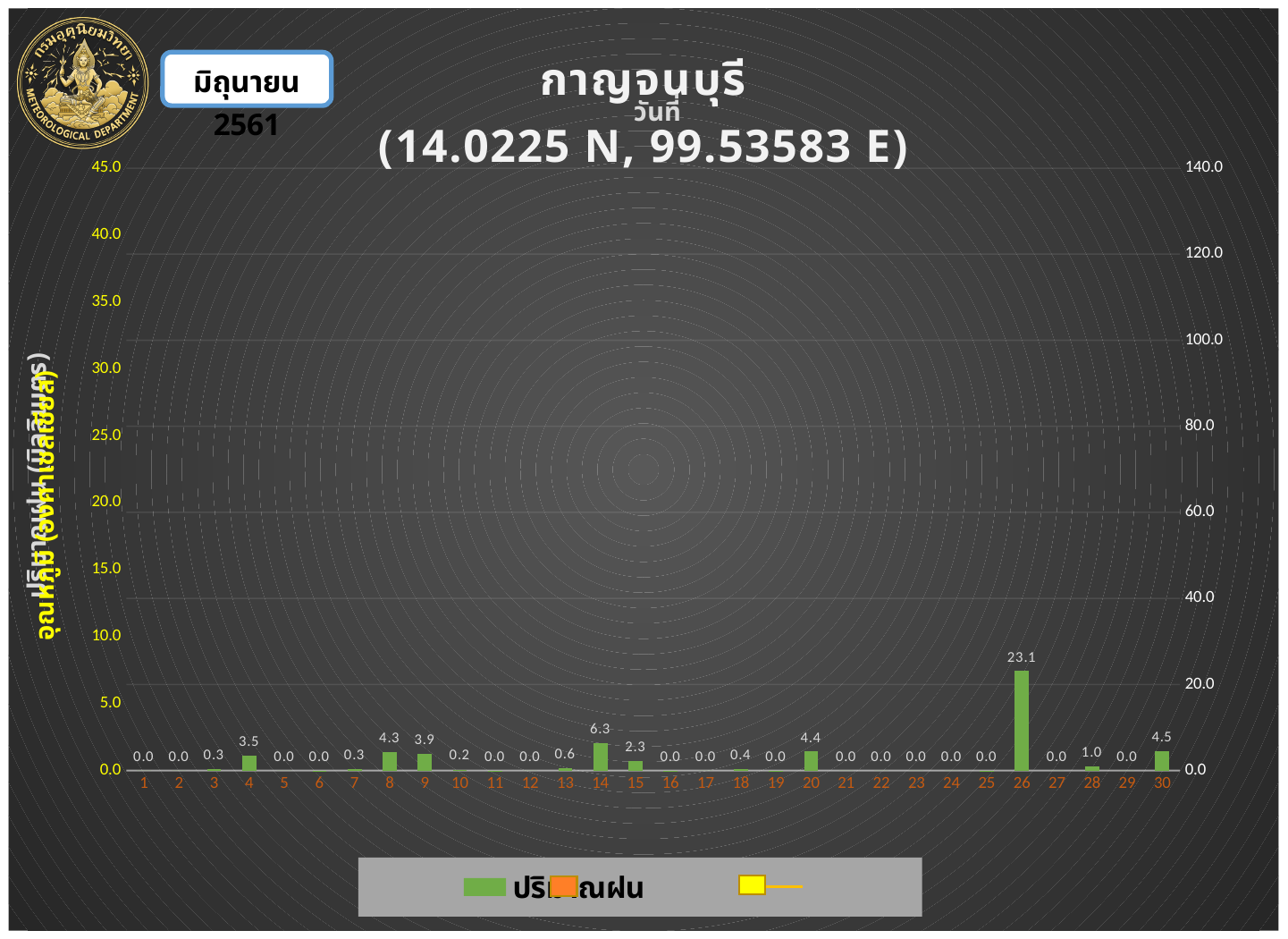
What colour are the rainfall (ปริมาณฝน) bars? green What is the rainfall value (ปริมาณฝน) for day 26? 23.1 Is the rainfall value for day 26 greater or less than 20.0 on the right axis? greater Which day has the highest rainfall value? 26 What is the rainfall value for day 14? 6.3 What is the difference between the rainfall values for day 8 and day 9? 0.4 What is the rainfall value for day 8? 4.3 What kind of chart is used to show the rainfall values? bar chart Which has the larger rainfall value, day 20 or day 15? day 20 How many days are shown on the x axis? 30 What is the difference between the rainfall values for day 26 and day 14? 16.8 What is the rainfall value for day 30? 4.5